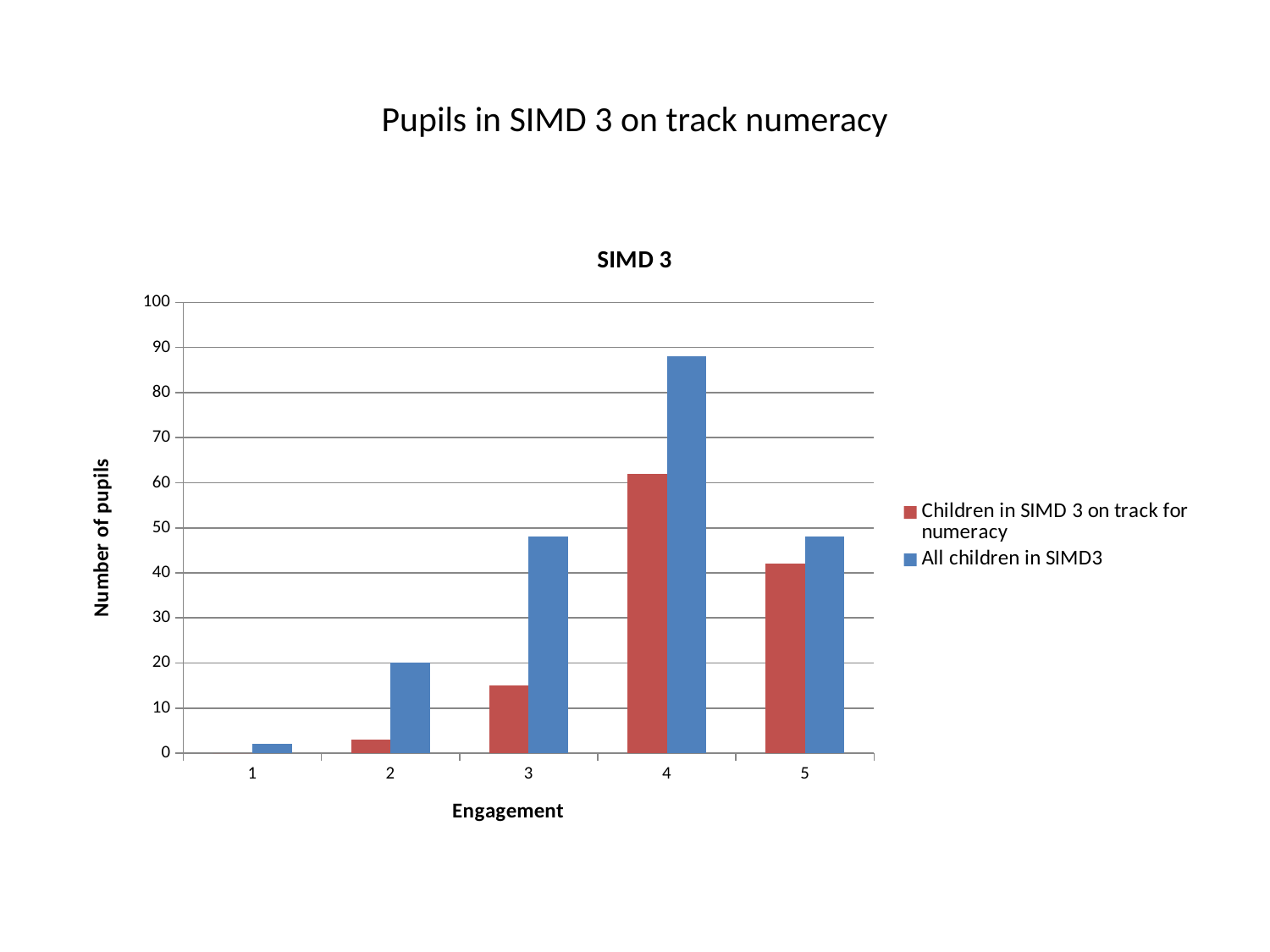
At which engagement level is the value for Children in SIMD 3 on track for numeracy highest? 4 How many engagement categories are shown on the x axis? 5 What kind of chart is shown on the slide? bar chart How many series does the legend list? 2 At which engagement level is the value for All children in SIMD3 highest? 4 Is the value for Children in SIMD 3 on track for numeracy at engagement 3 greater or less than 20? less Is the value for All children in SIMD3 at engagement 4 greater or less than 80? greater What is the value for All children in SIMD3 at engagement 2? 20 What is the label of the y axis? Number of pupils At which engagement level is the value for All children in SIMD3 lowest? 1 What is the title of the chart? SIMD 3 At engagement 4, which series has the larger value: Children in SIMD 3 on track for numeracy or All children in SIMD3? All children in SIMD3